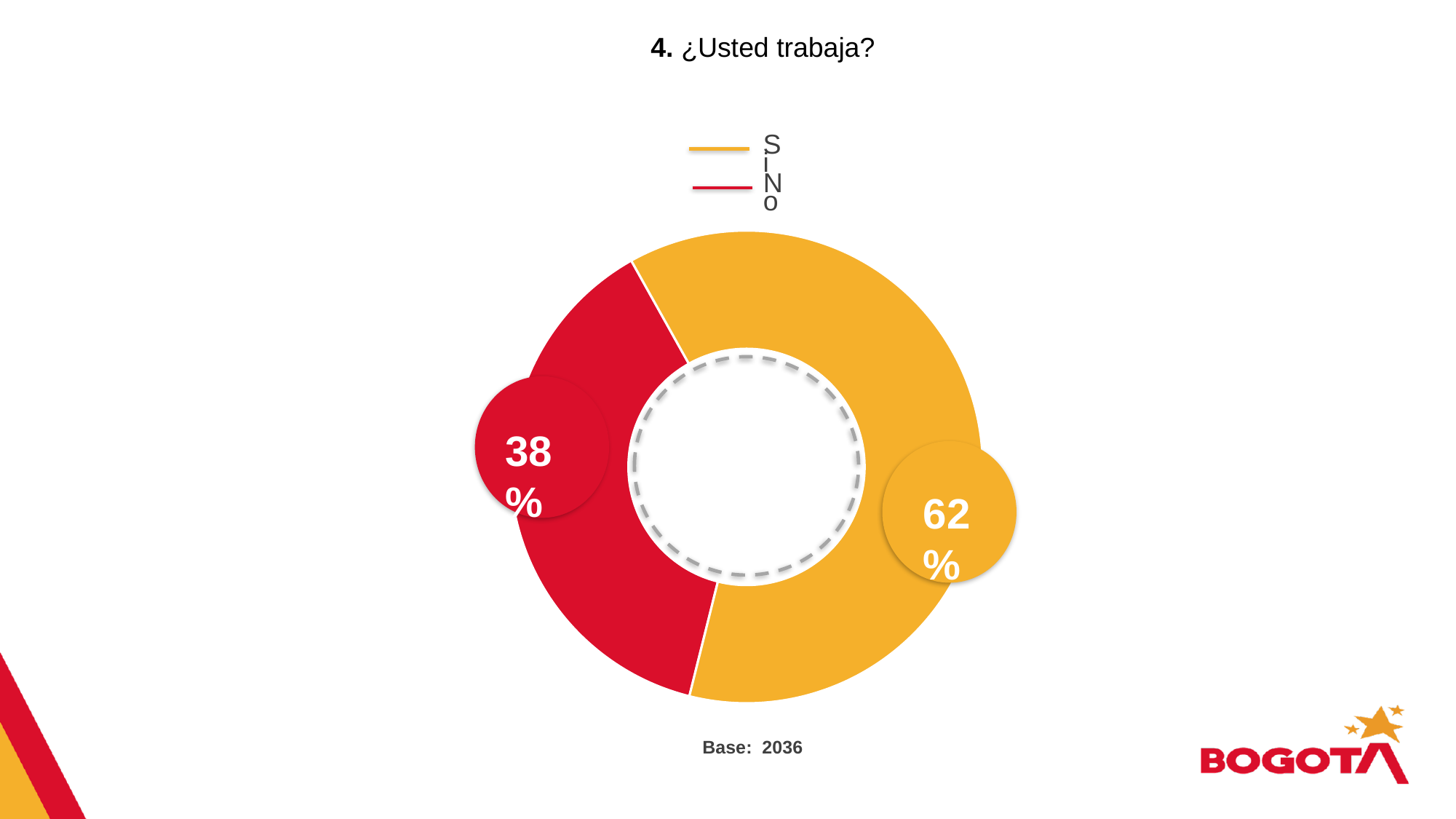
Is the share for "Si" greater or less than 50%? greater Which response has the larger share of the chart, "Si" or "No"? Si What kind of chart is shown on the slide? Pie chart (doughnut) What percentage of respondents answered "No" to "¿Usted trabaja?"? 38% What is the base (number of respondents) shown below the chart? 2036 How many categories are shown in the chart? 2 What is the difference in percentage points between the "Si" and "No" shares? 24 What colour represents the "No" response in the chart? Red Is the share for "No" greater or less than 50%? less What percentage of respondents answered "Si" to "¿Usted trabaja?"? 62% Which response has the smaller share of the chart? No What is the total of the two shares shown in the chart? 100%